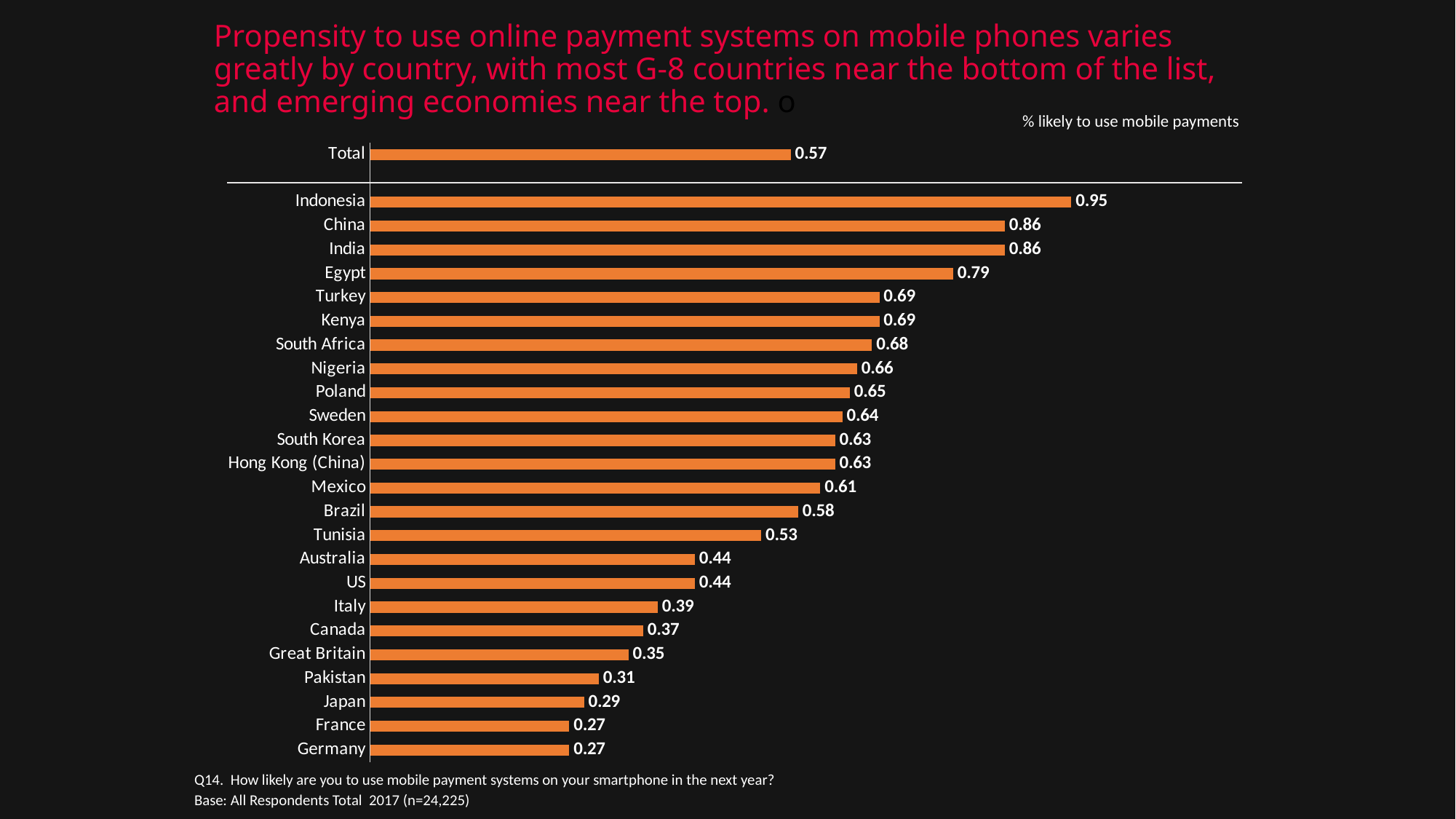
What is the difference between the values for Indonesia and Germany? 0.68 Which is larger, the value for Canada or the value for Tunisia? Tunisia What is the value for Total? 0.57 What kind of chart is shown on the slide? Bar chart Which is larger, the value for Egypt or the value for Turkey? Egypt What is the difference between the values for Egypt and Brazil? 0.21 How many countries are listed below the Total bar? 24 Which country has the highest value? Indonesia What is the value for Japan? 0.29 What is the value for Indonesia? 0.95 What does the label above the chart say the values represent? % likely to use mobile payments What is the value for Great Britain? 0.35